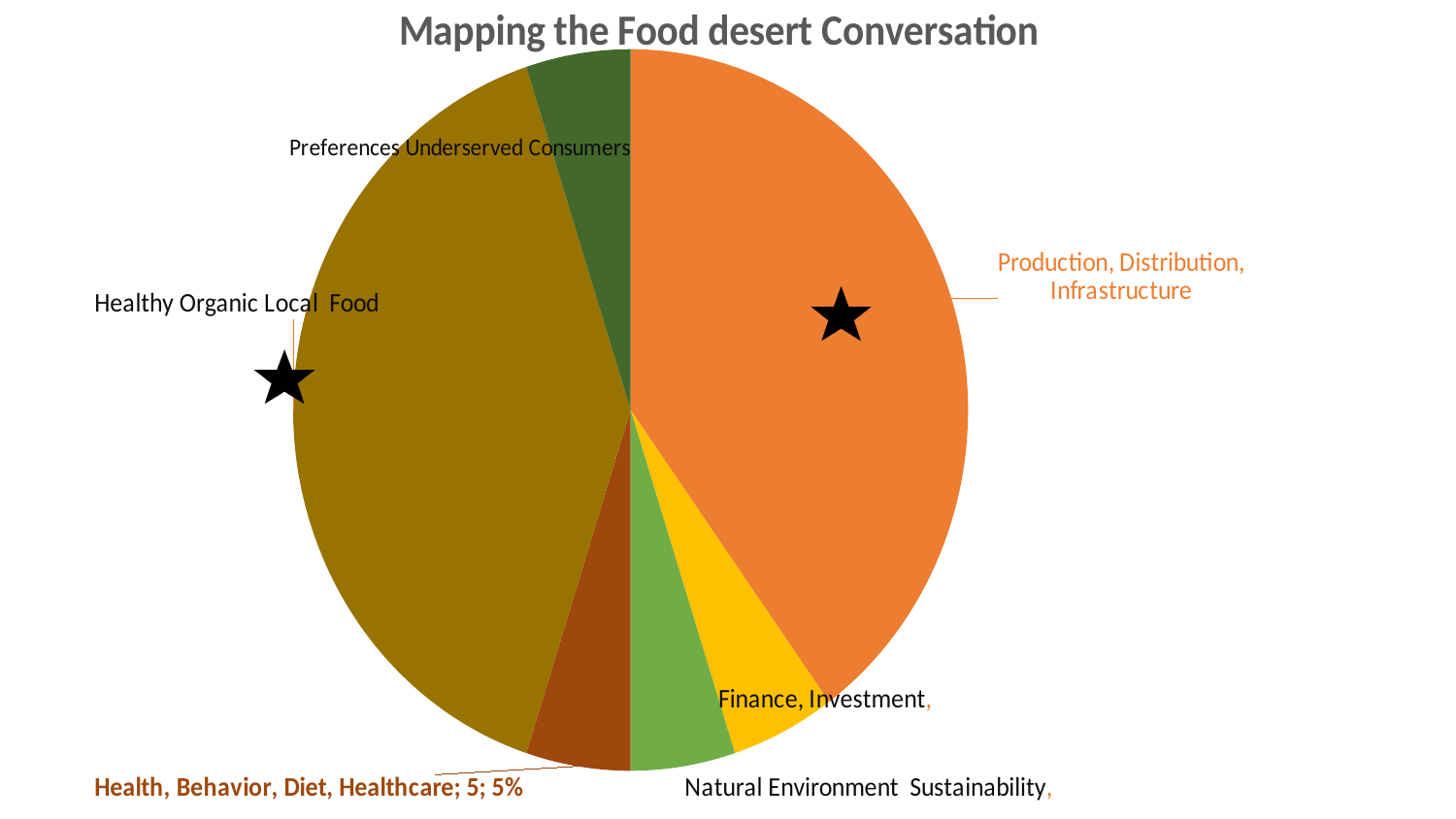
What value is printed for the Health, Behavior, Diet, Healthcare slice? 5 Which slice is larger: Production, Distribution, Infrastructure or Finance, Investment? Production, Distribution, Infrastructure Which slice is larger: Healthy Organic Local Food or Natural Environment Sustainability? Healthy Organic Local Food What share of the pie does the Health, Behavior, Diet, Healthcare slice represent? 5% What is the title of the chart? Mapping the Food desert Conversation Which slice is larger: Healthy Organic Local Food or Preferences Underserved Consumers? Healthy Organic Local Food What colour is the Production, Distribution, Infrastructure slice? orange What kind of chart is shown on the slide? pie chart How many slices does the pie chart have? 6